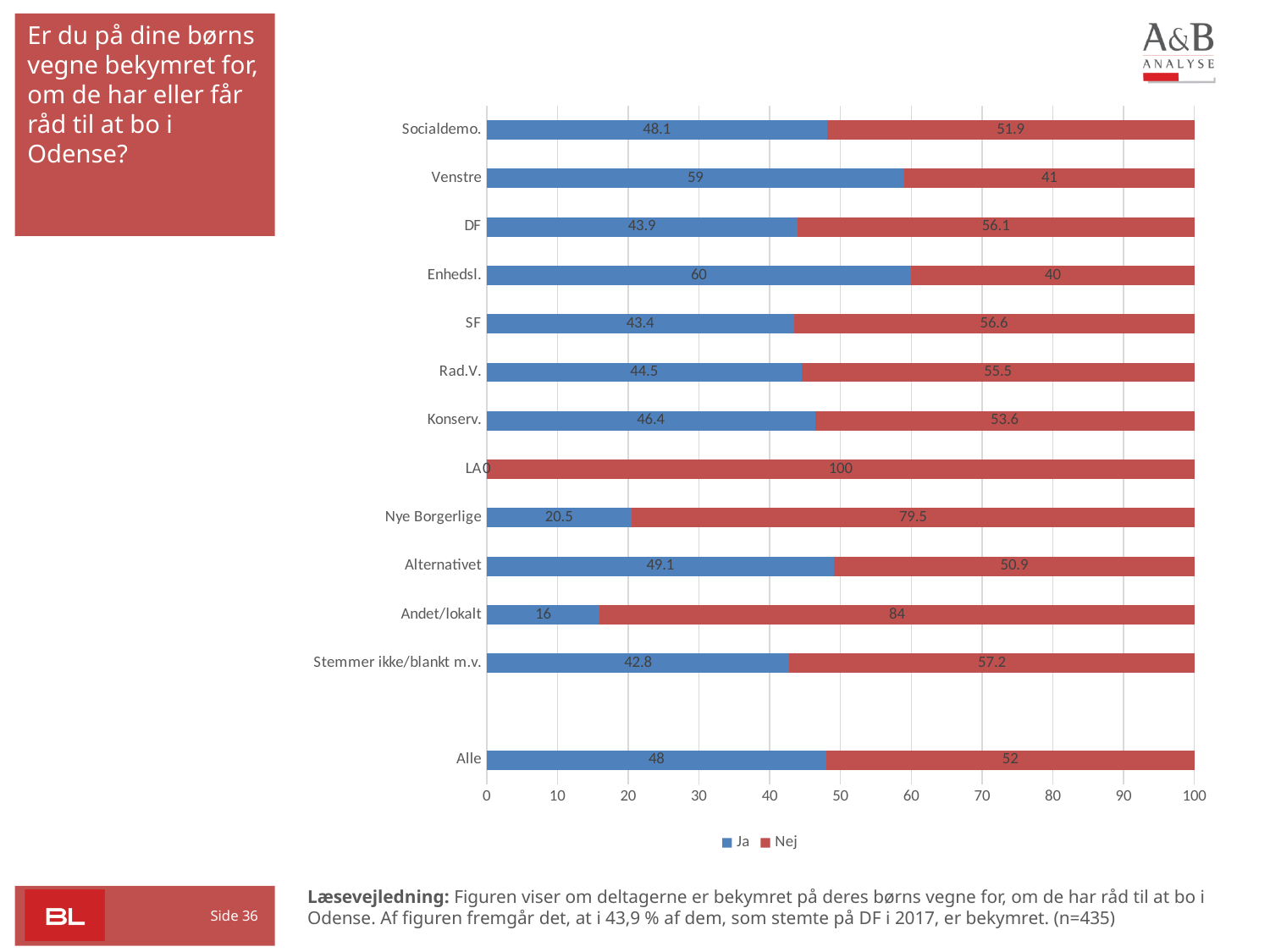
What is the "Ja" value for DF? 43.9 How many categories are shown on the y axis? 13 Which category has the lowest "Ja" value? LA What is the difference between the "Ja" and "Nej" values for Venstre? 18 What kind of chart is shown on the slide? Stacked bar chart Which category has the highest "Nej" value? LA How many series does the legend list? 2 Which category has the highest "Ja" value? Enhedsl. What is the "Ja" value for Alle? 48 Which has a larger "Ja" value, Socialdemo. or Alternativet? Alternativet What are the two legend entries of the chart? Ja and Nej What is the "Nej" value for Nye Borgerlige? 79.5